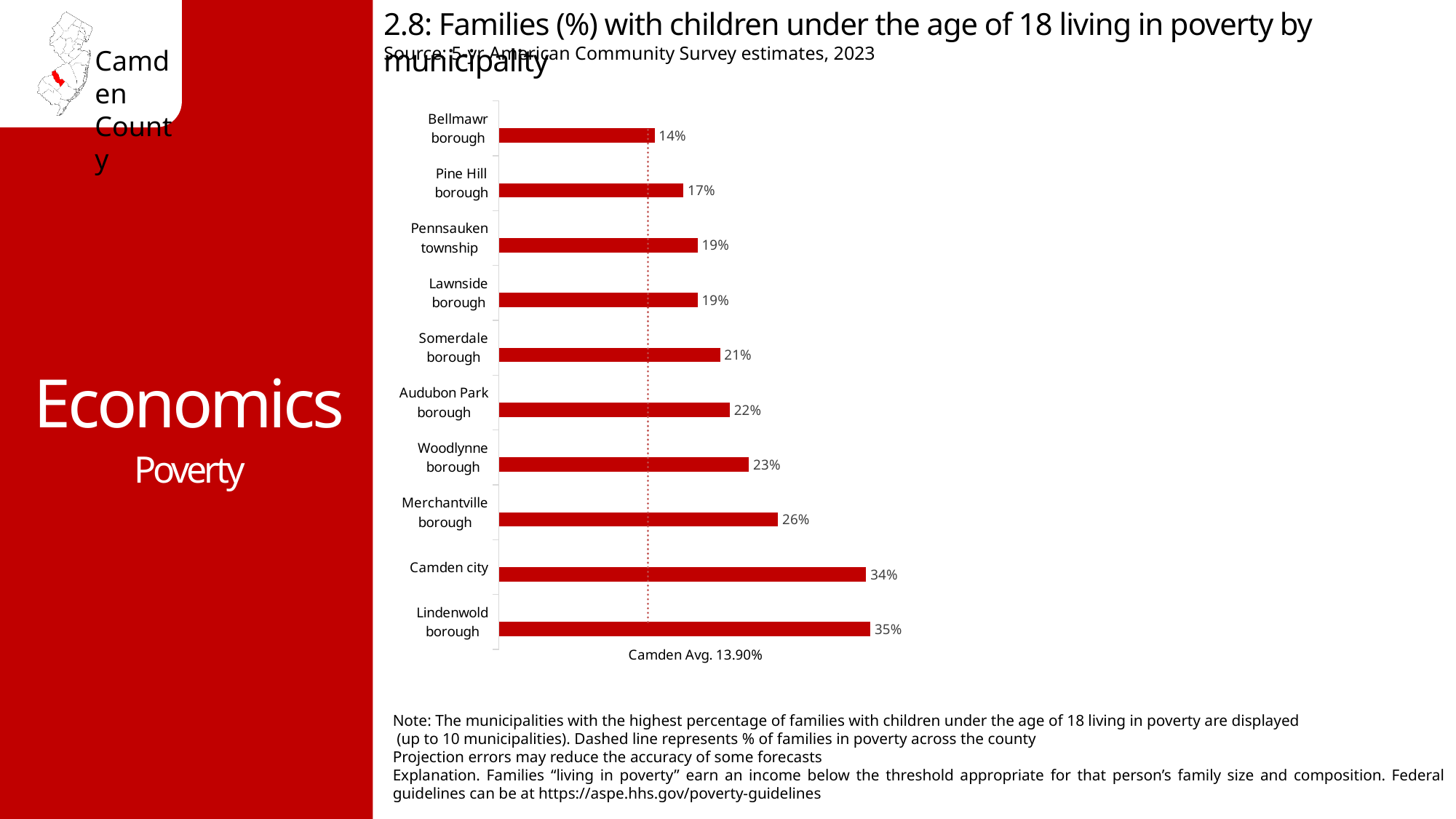
Which two municipalities both have a value of 19%? Pennsauken township and Lawnside borough What kind of chart is shown on the slide? Bar chart What is the value for Bellmawr borough? 14% What is the difference between the values for Lindenwold borough and Bellmawr borough? 21% How many municipalities are shown in the chart? 10 Which municipality has the lowest value? Bellmawr borough What is the difference between the values for Merchantville borough and Somerdale borough? 5% What is the value for Woodlynne borough? 23% Which municipality has the highest value? Lindenwold borough What is the value for Camden city? 34% What is the Camden average shown by the dashed line? 13.90% Which is larger, the value for Pine Hill borough or the value for Audubon Park borough? Audubon Park borough